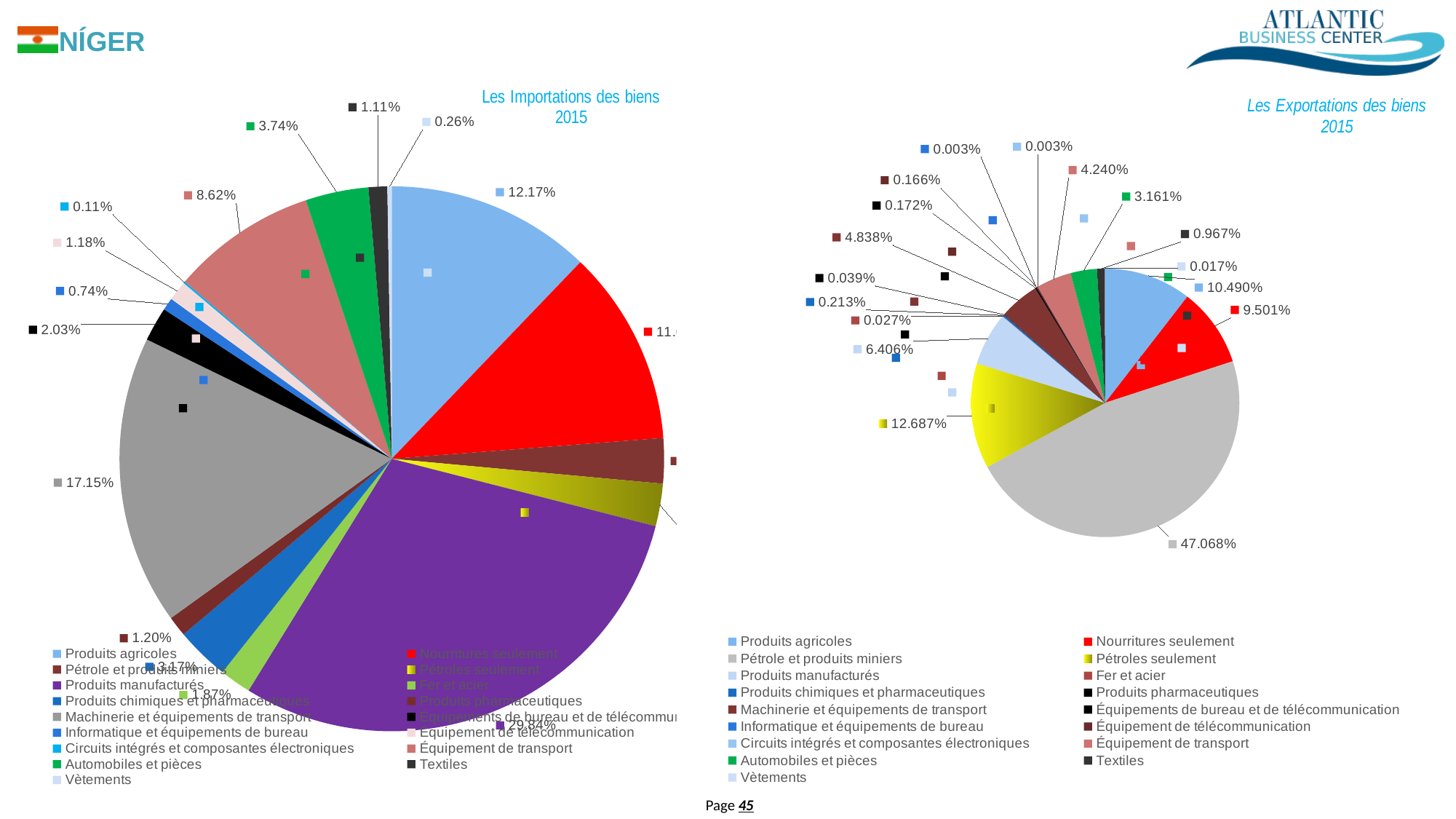
On the 'Les Exportations des biens 2015' chart, what share is shown for Nourritures seulement? 9.501% On the 'Les Exportations des biens 2015' chart, what is the difference between the shares of Produits agricoles and Nourritures seulement? 0.989% On the 'Les Importations des biens 2015' chart, what share is shown for Équipement de transport? 8.62% What type of chart is used for 'Les Exportations des biens 2015'? Pie chart How many categories does the legend of the 'Les Exportations des biens 2015' chart list? 17 On the 'Les Importations des biens 2015' chart, which category has the largest slice? Produits manufacturés On the 'Les Exportations des biens 2015' chart, what share is shown for Pétrole et produits miniers? 47.068% On the 'Les Importations des biens 2015' chart, what share is shown for Machinerie et équipements de transport? 17.15% On the 'Les Exportations des biens 2015' chart, which category has the largest slice? Pétrole et produits miniers On the 'Les Importations des biens 2015' chart, what share is shown for Produits agricoles? 12.17% On the 'Les Importations des biens 2015' chart, which is larger: Automobiles et pièces or Produits chimiques et pharmaceutiques? Automobiles et pièces On the 'Les Exportations des biens 2015' chart, what share is shown for Pétroles seulement? 12.687%